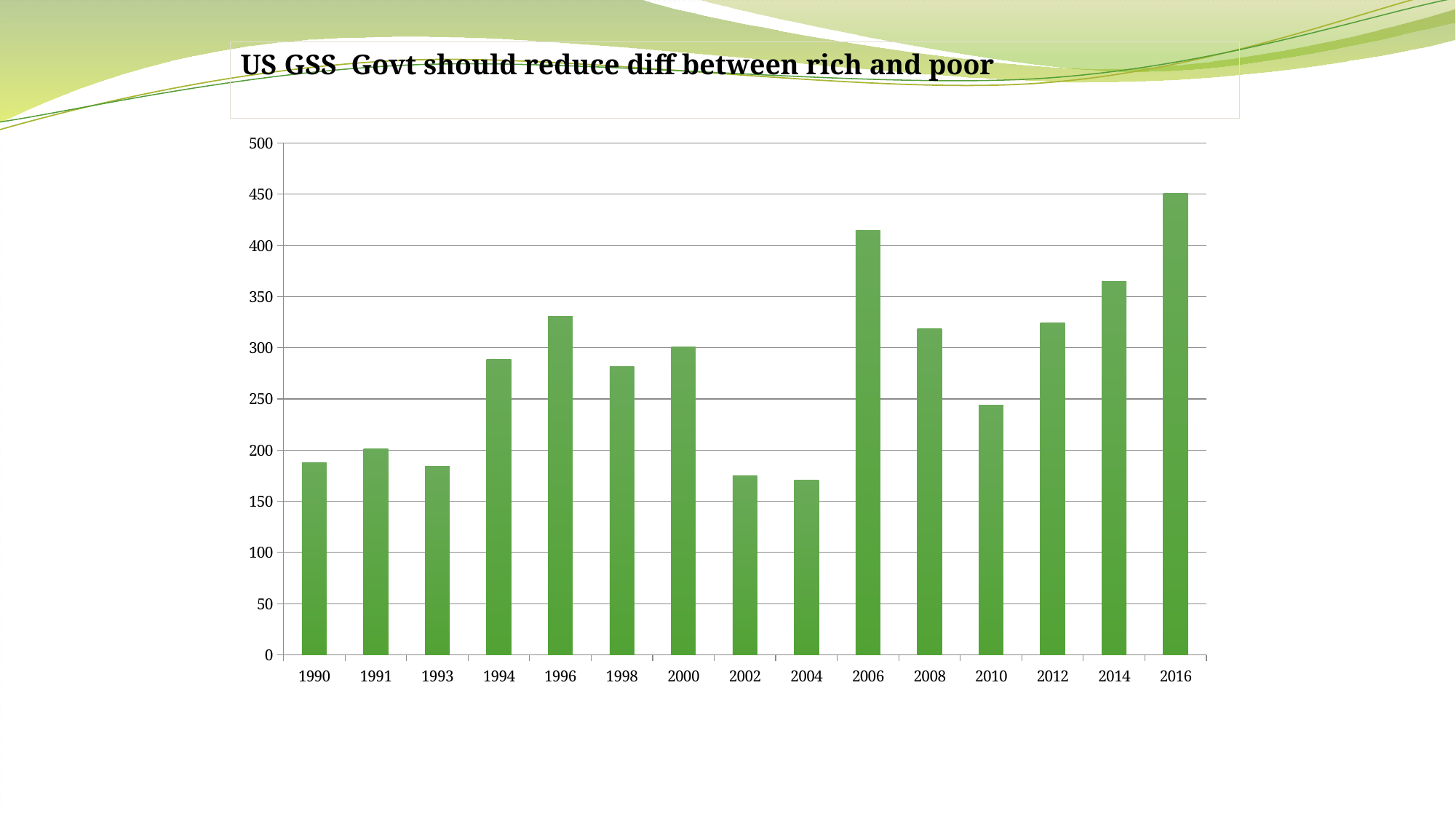
What is the title of the chart? US GSS Govt should reduce diff between rich and poor Is the value for 2010 greater or less than 250? less Which year has the highest bar? 2016 Is the value for 1996 greater or less than 300? greater Which is larger, the value for 1996 or the value for 1998? 1996 Is the value for 2002 greater or less than 200? less What kind of chart is shown on the slide? bar chart How many years are shown on the x axis of the chart? 15 Do the values rise or fall from 2010 to 2016? rise Which is larger, the value for 2006 or the value for 2008? 2006